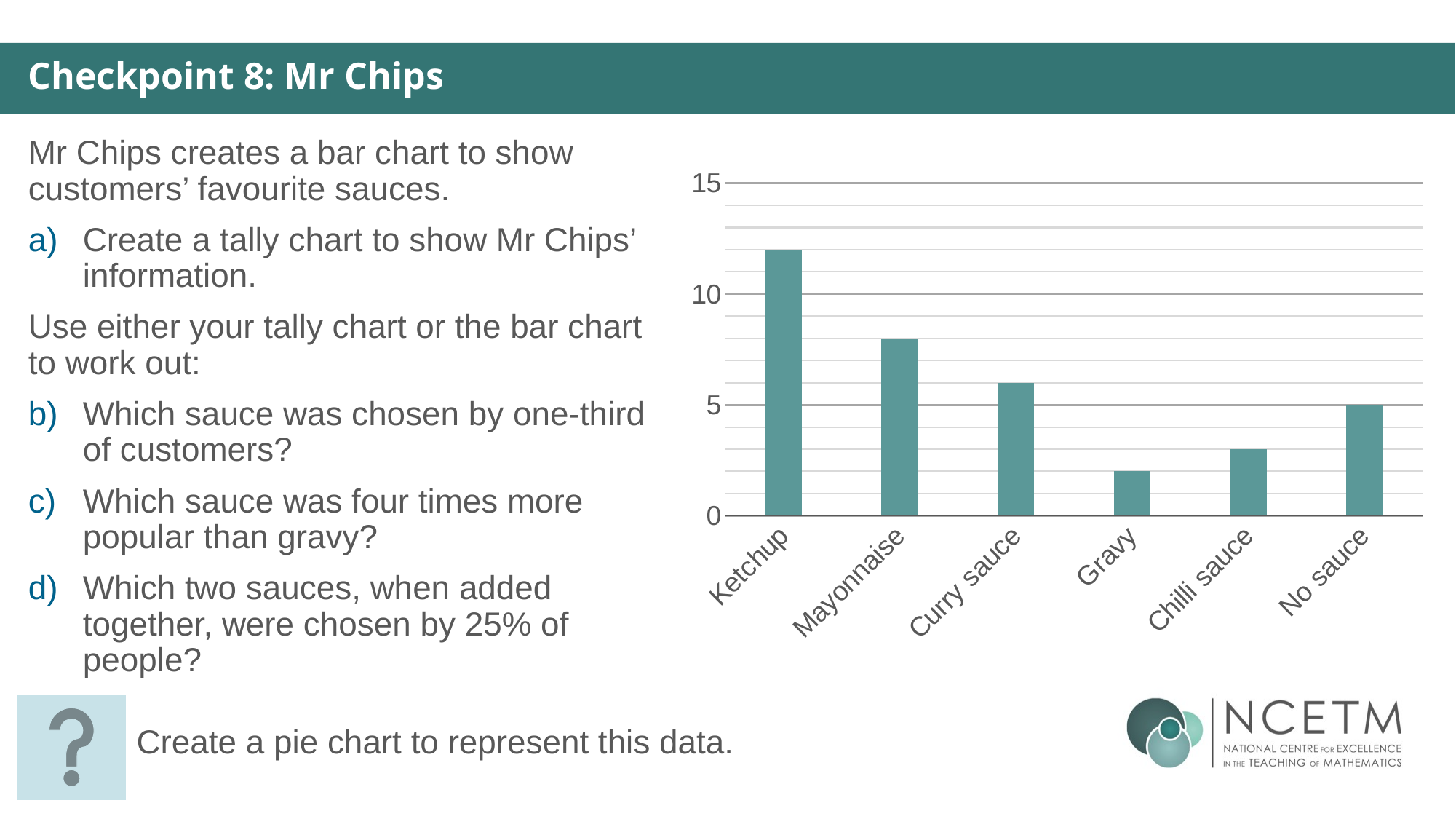
What value does the No sauce bar reach on the y axis? 5 What kind of chart is shown on the slide? bar chart Which sauce has the shortest bar in the chart? Gravy Which bar is taller, Chilli sauce or No sauce? No sauce Moving along the x axis from Ketchup to Gravy, do the bar values rise or fall? fall Which bar is taller, Mayonnaise or Curry sauce? Mayonnaise Is the value for Ketchup greater or less than 10? greater What is the highest value labelled on the y axis of the chart? 15 Which sauce has the tallest bar in the chart? Ketchup How many sauce categories are shown on the x axis of the chart? 6 Is the value for Gravy greater or less than 5? less Is the value for Mayonnaise greater or less than 10? less